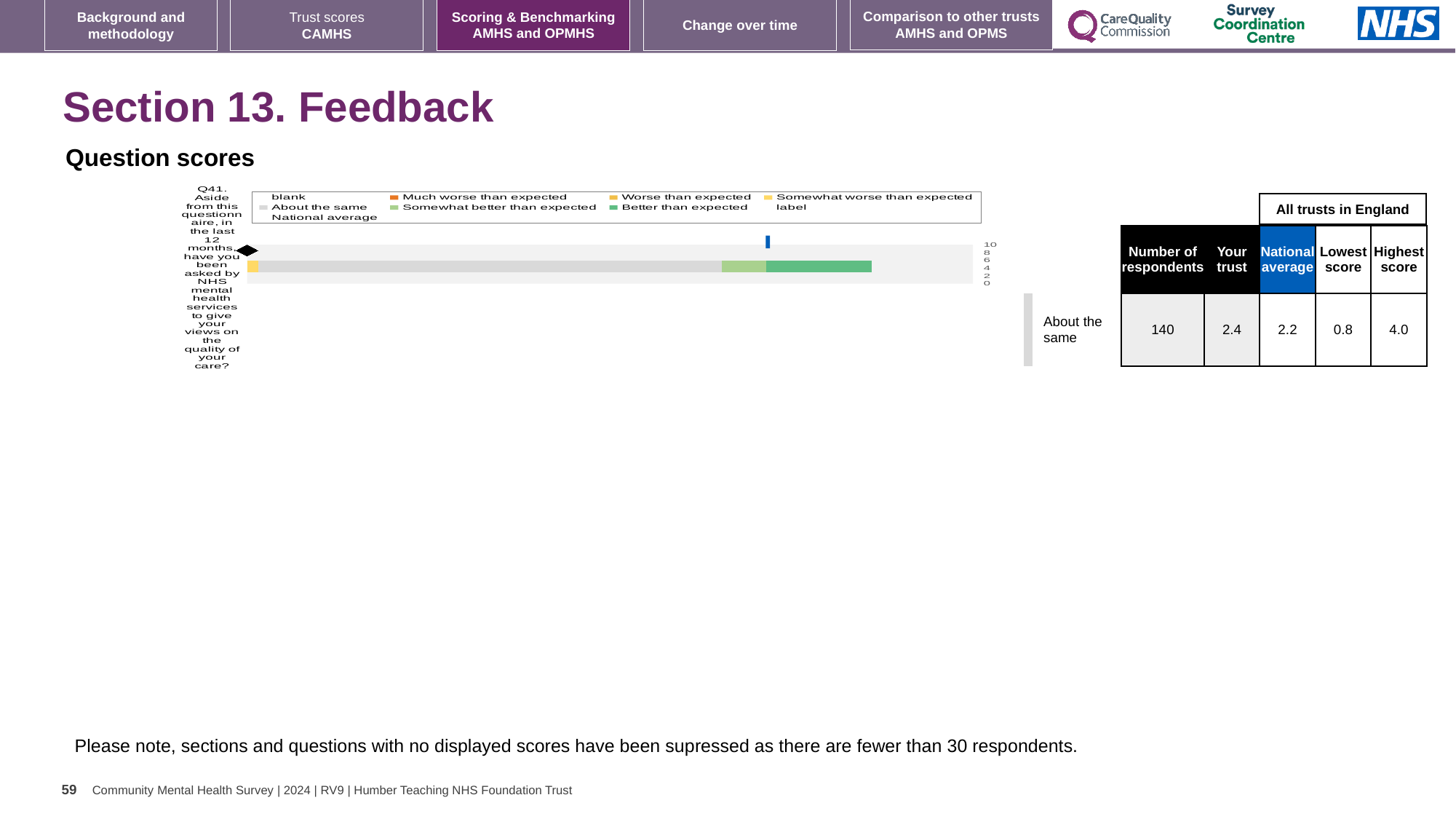
What is the difference between the highest and lowest scores for Q41 across all trusts in England? 3.2 By how much does the trust's Q41 score exceed the national average? 0.2 How many survey questions are plotted in the Question scores chart? 1 What is the national average score for Q41? 2.2 What is the 'Your trust' score for Q41? 2.4 What benchmark category is the trust's Q41 score placed in? About the same For Q41, which is higher: the trust's score or the national average? Your trust What is the highest score among all trusts in England for Q41? 4.0 What kind of chart is used to show the Q41 question score? bar chart What is the lowest score among all trusts in England for Q41? 0.8 How many respondents answered Q41? 140 Which question number is plotted in the Question scores chart? Q41